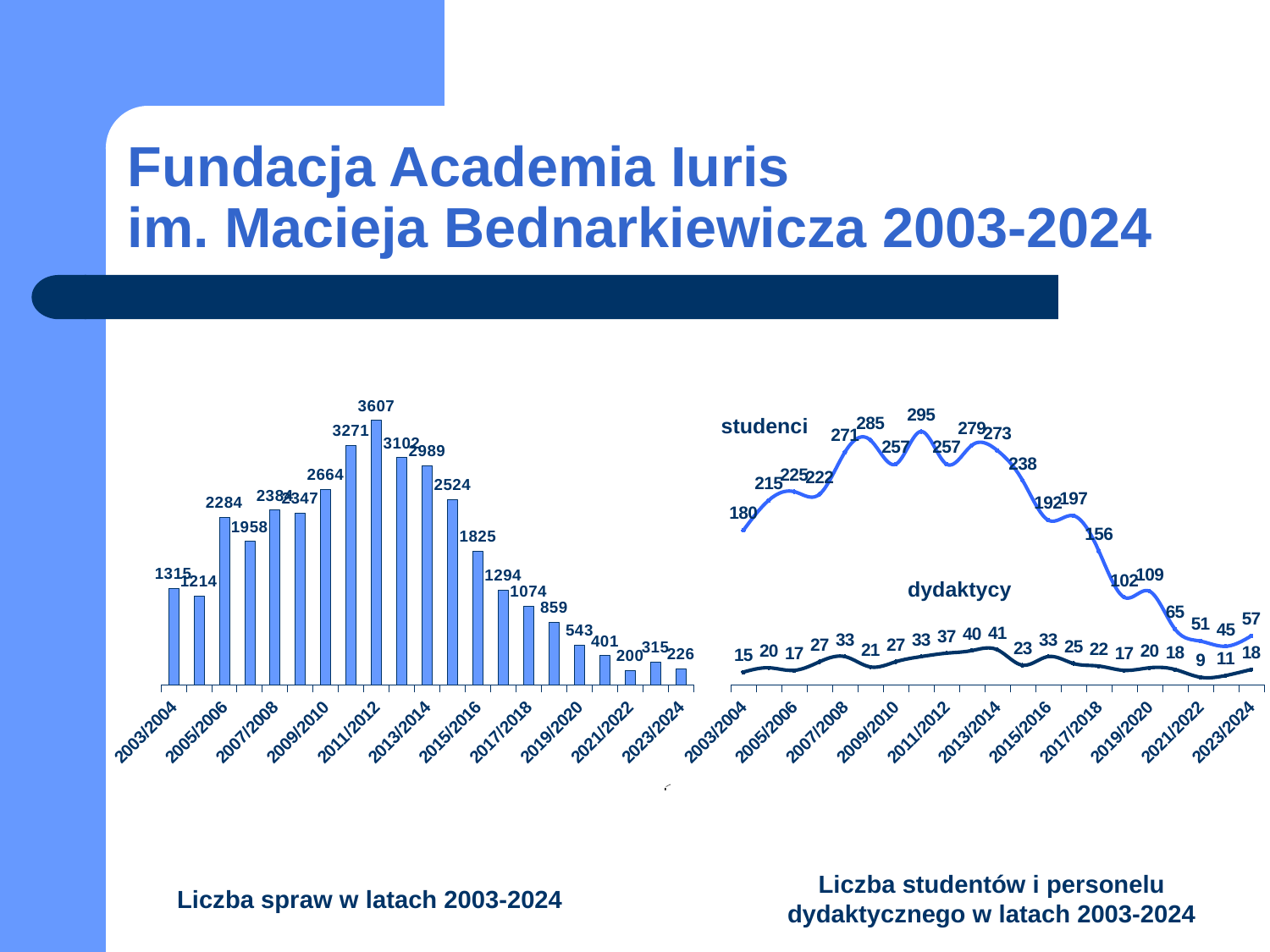
In the left chart 'Liczba spraw w latach 2003-2024', what is the difference between the values for 2011/2012 and 2013/2014? 618 In the right chart 'Liczba studentów i personelu dydaktycznego w latach 2003-2024', what is the lowest value of 'dydaktycy'? 9 In the right chart 'Liczba studentów i personelu dydaktycznego w latach 2003-2024', what is the value of 'dydaktycy' for 2013/2014? 41 What kind of chart is the left chart, 'Liczba spraw w latach 2003-2024'? bar chart In the left chart 'Liczba spraw w latach 2003-2024', which is larger, the value for 2005/2006 or the value for 2007/2008? 2007/2008 In the left chart 'Liczba spraw w latach 2003-2024', what is the highest value shown? 3607 In the left chart 'Liczba spraw w latach 2003-2024', what is the value for 2011/2012? 3607 In the right chart 'Liczba studentów i personelu dydaktycznego w latach 2003-2024', what is the value of 'studenci' for 2003/2004? 180 In the left chart 'Liczba spraw w latach 2003-2024', what is the lowest value shown? 200 In the left chart 'Liczba spraw w latach 2003-2024', what is the value for 2023/2024? 226 How many series does the right chart 'Liczba studentów i personelu dydaktycznego w latach 2003-2024' show? 2 In the right chart 'Liczba studentów i personelu dydaktycznego w latach 2003-2024', what is the highest value of 'studenci'? 295